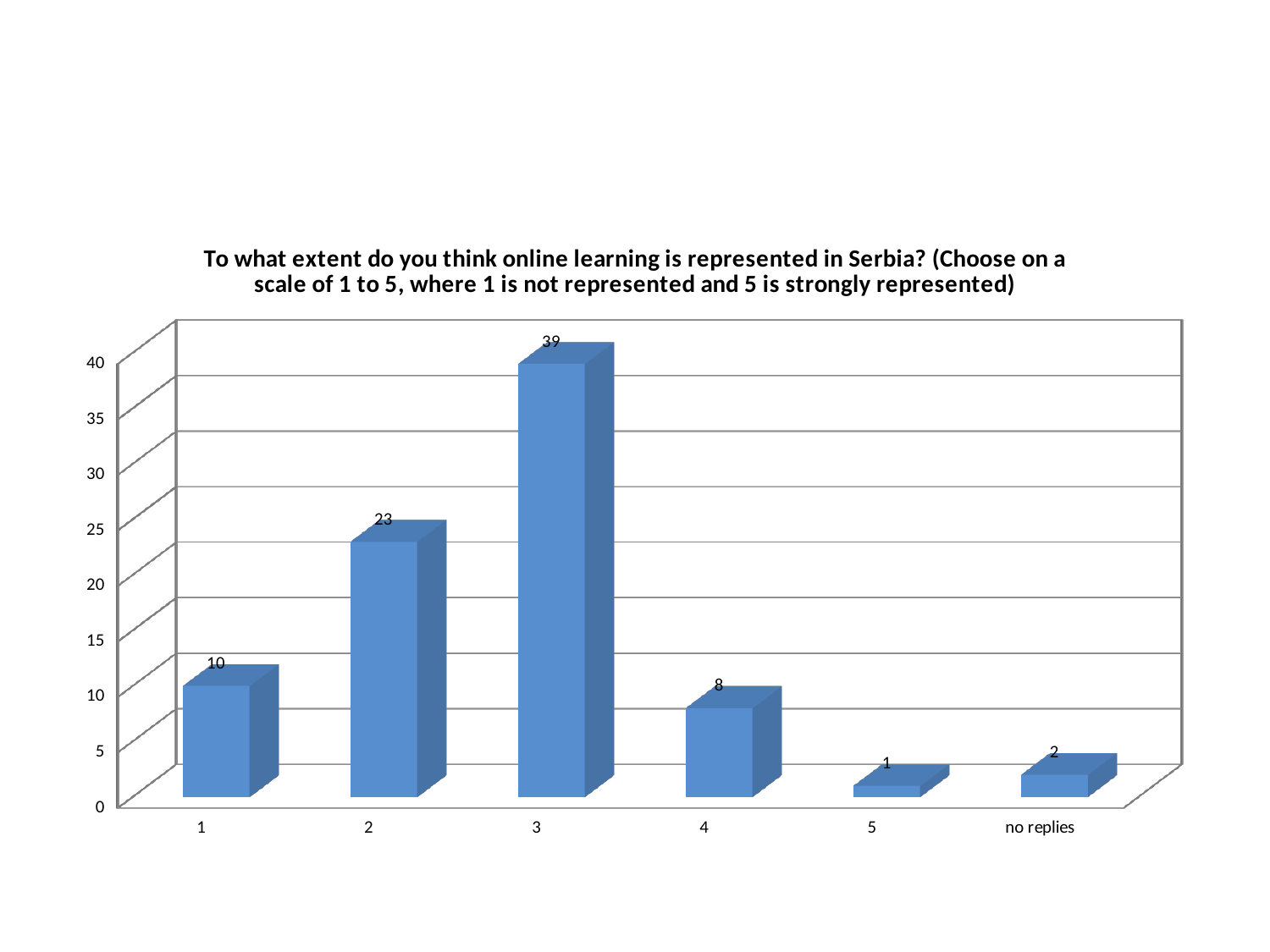
Which category has the lowest value? 5 What is the difference between the values for category 1 and category 4? 2 Which is larger, the value for category 2 or the value for category 4? 2 What is the difference between the values for category 3 and category 2? 16 What is the highest value shown on the vertical axis? 40 Do the values rise or fall from category 3 to category 5? fall What is the value for category 1? 10 What kind of chart is shown on the slide? bar chart What is the value for category 3? 39 How many categories are shown on the x axis? 6 What is the value for 'no replies'? 2 Which category has the highest value? 3